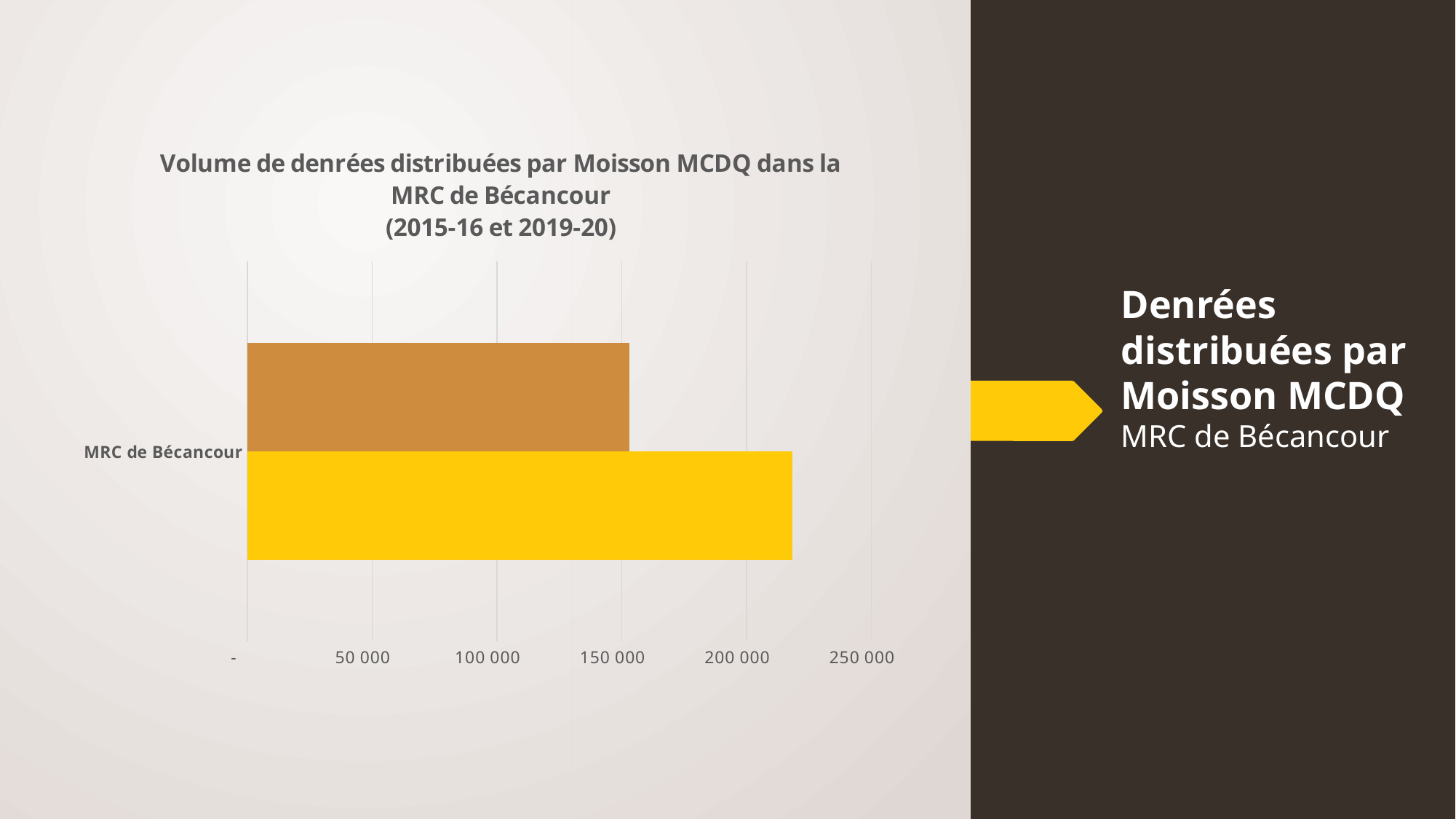
Which bar shows the highest value in the chart? the yellow bar How many categories are shown on the vertical axis of the chart? 1 What is the category label shown on the vertical axis? MRC de Bécancour What kind of chart is shown on the slide? bar chart Is the value of the brown bar greater or less than 200 000? less Is the value of the yellow bar greater or less than 200 000? greater Is the value of the brown bar greater or less than 100 000? greater What is the highest tick value shown on the horizontal axis? 250 000 Which bar is longer, the brown bar or the yellow bar? the yellow bar How many bars are plotted for MRC de Bécancour? 2